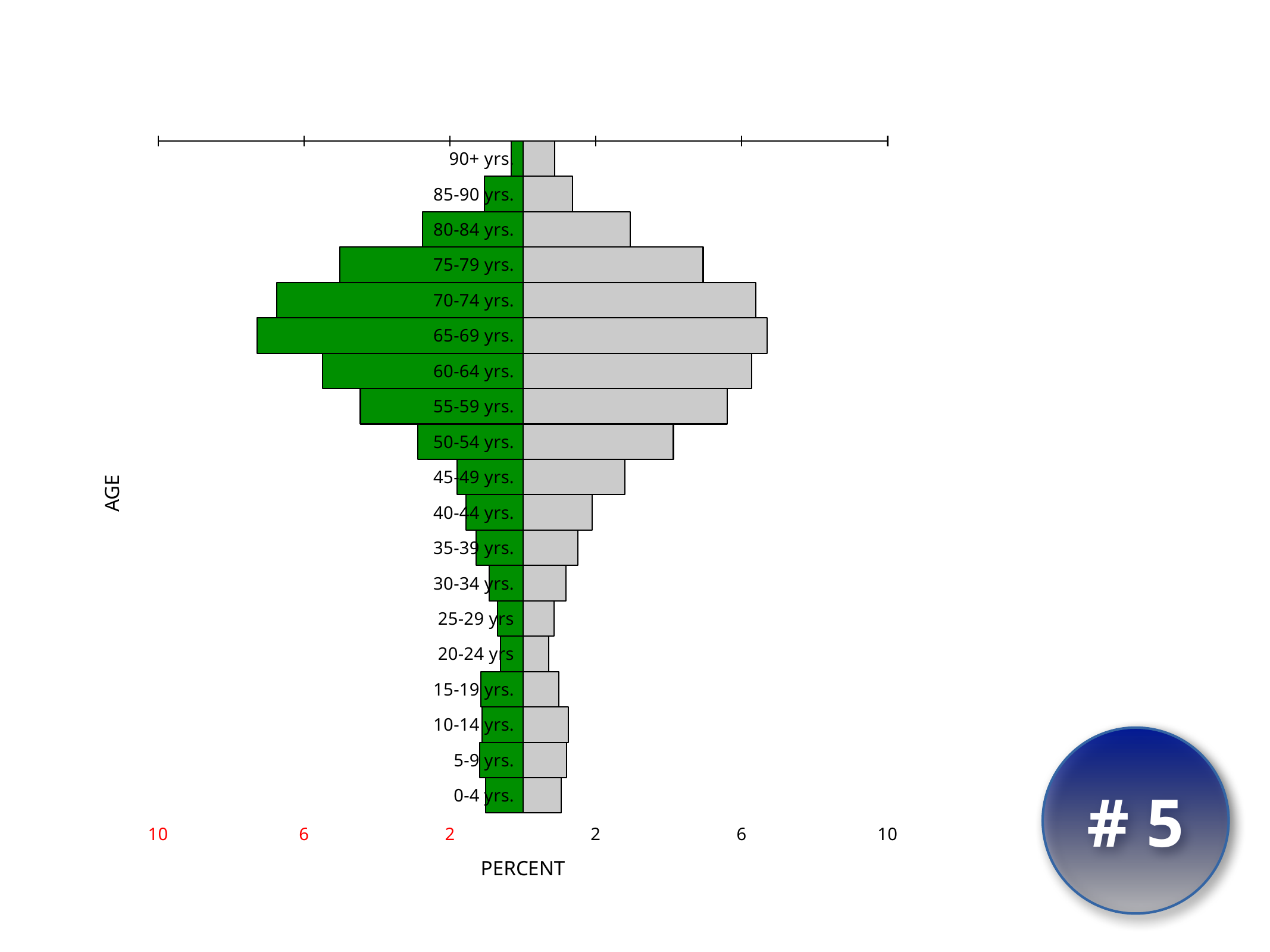
What kind of chart is shown on the slide? bar chart Is the grey bar value for 50-54 yrs. greater or less than 2? greater Which age group has the shortest green bar? 90+ yrs. Is the green bar value for 75-79 yrs. greater or less than 6? less Which age group has the longest green bar? 65-69 yrs. What is the label on the horizontal axis of the chart? PERCENT Which green bar is longer, 65-69 yrs. or 75-79 yrs.? 65-69 yrs. Which age group has the longest grey bar? 65-69 yrs. Which grey bar is longer, 50-54 yrs. or 40-44 yrs.? 50-54 yrs. Is the green bar value for 65-69 yrs. greater or less than 6? greater How many age groups are plotted on the chart? 19